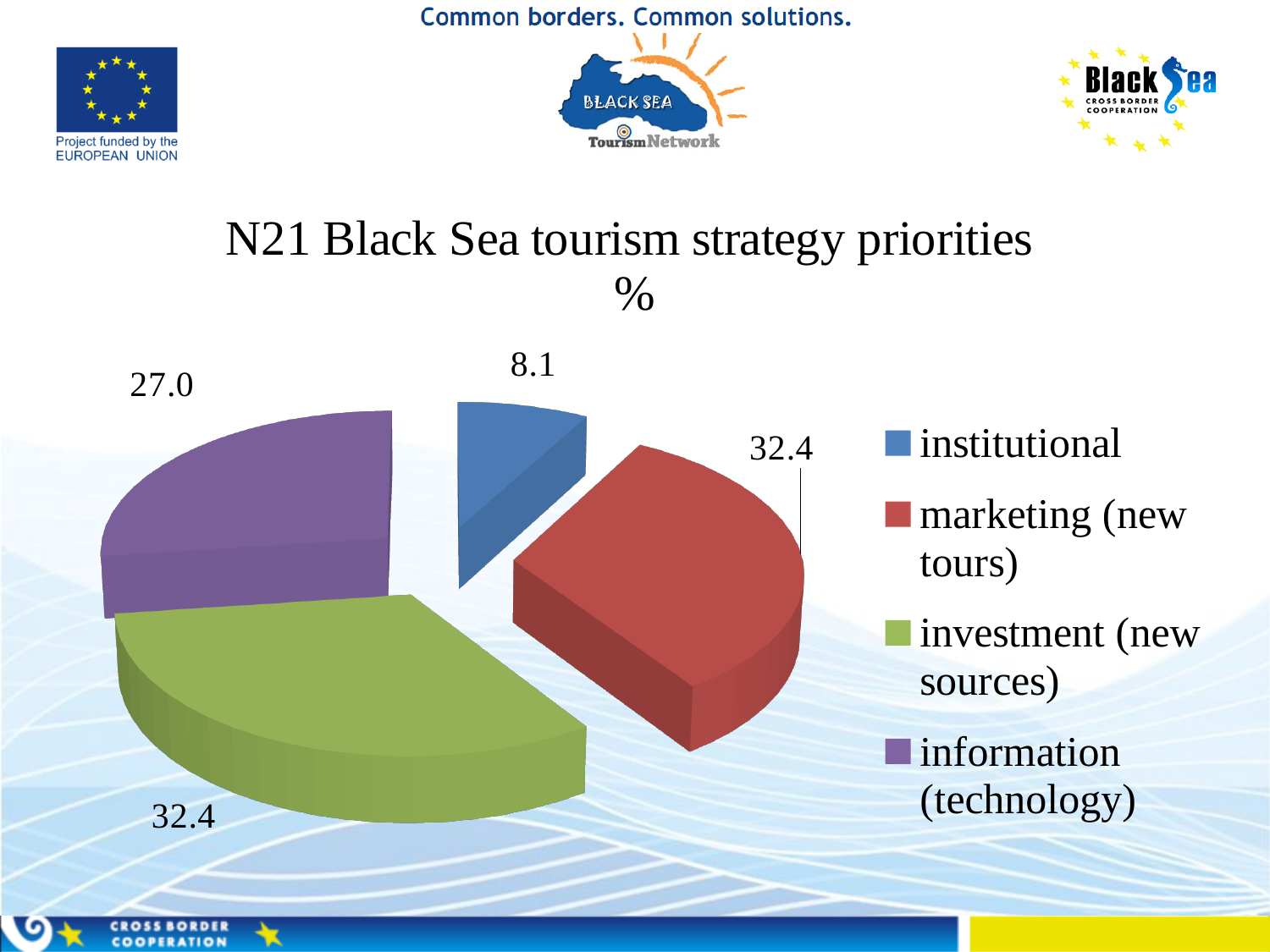
How many slices does the pie chart have? 4 What is the value for investment (new sources)? 32.4 What is the value for institutional? 8.1 What kind of chart is shown on the slide? pie chart What is the title of the chart? N21 Black Sea tourism strategy priorities % What is the difference between the values for information (technology) and institutional? 18.9 Which colour represents investment (new sources) in the legend? green What is the value for information (technology)? 27.0 Which category has the smallest slice of the pie? institutional Which is larger, the value for information (technology) or the value for institutional? information (technology) What is the value for marketing (new tours)? 32.4 What is the difference between the values for marketing (new tours) and information (technology)? 5.4